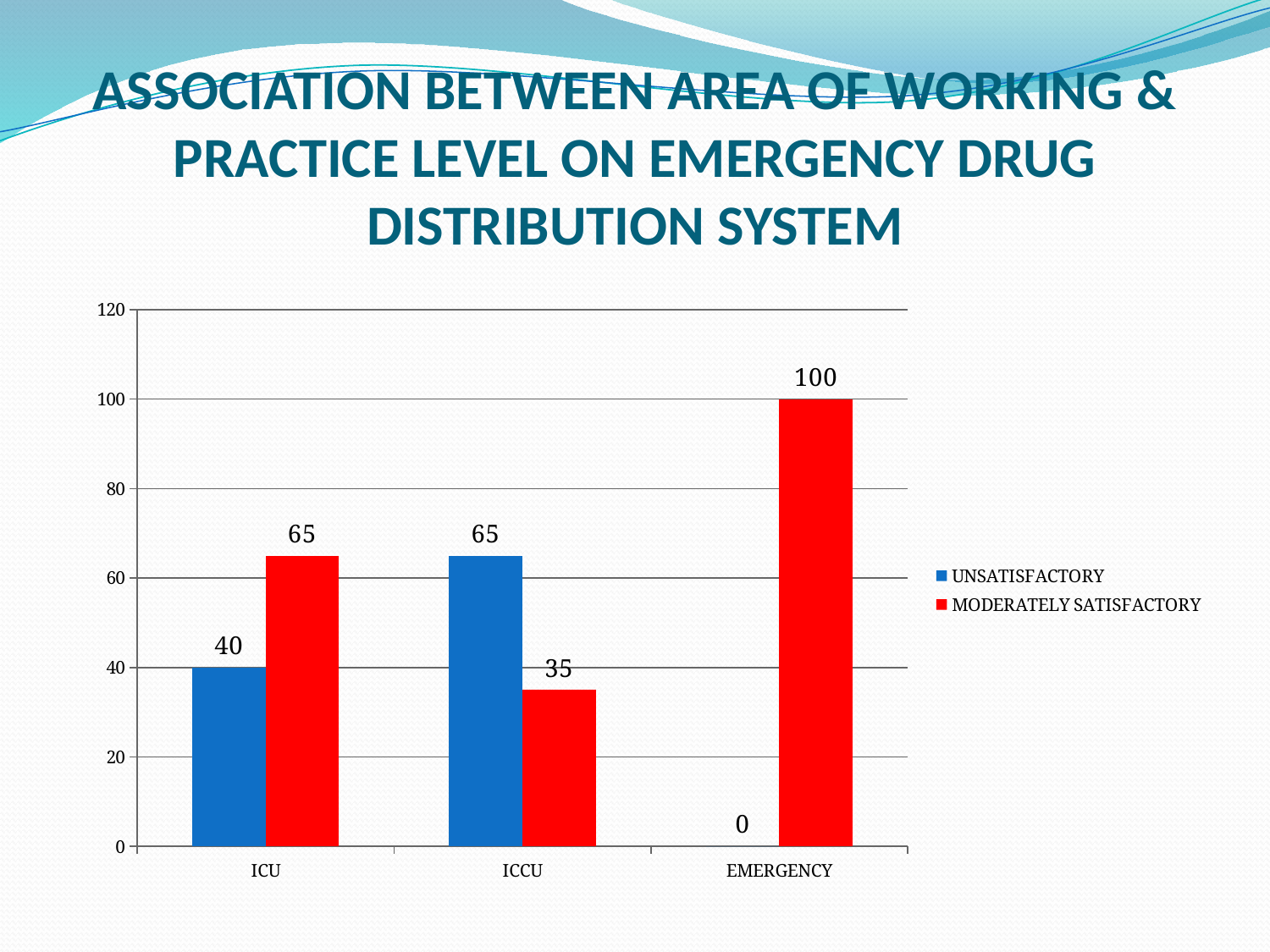
How many series does the legend list? 2 Which area has the lowest UNSATISFACTORY value? EMERGENCY Which area has the highest MODERATELY SATISFACTORY value? EMERGENCY What is the UNSATISFACTORY value for EMERGENCY? 0 What colour represents the MODERATELY SATISFACTORY series? Red How many areas of working are shown on the x axis? 3 What is the UNSATISFACTORY value for ICU? 40 What is the MODERATELY SATISFACTORY value for EMERGENCY? 100 What kind of chart is shown on the slide? Bar chart What is the difference between the MODERATELY SATISFACTORY values for EMERGENCY and ICCU? 65 What is the MODERATELY SATISFACTORY value for ICCU? 35 Which is larger for ICCU: UNSATISFACTORY or MODERATELY SATISFACTORY? UNSATISFACTORY